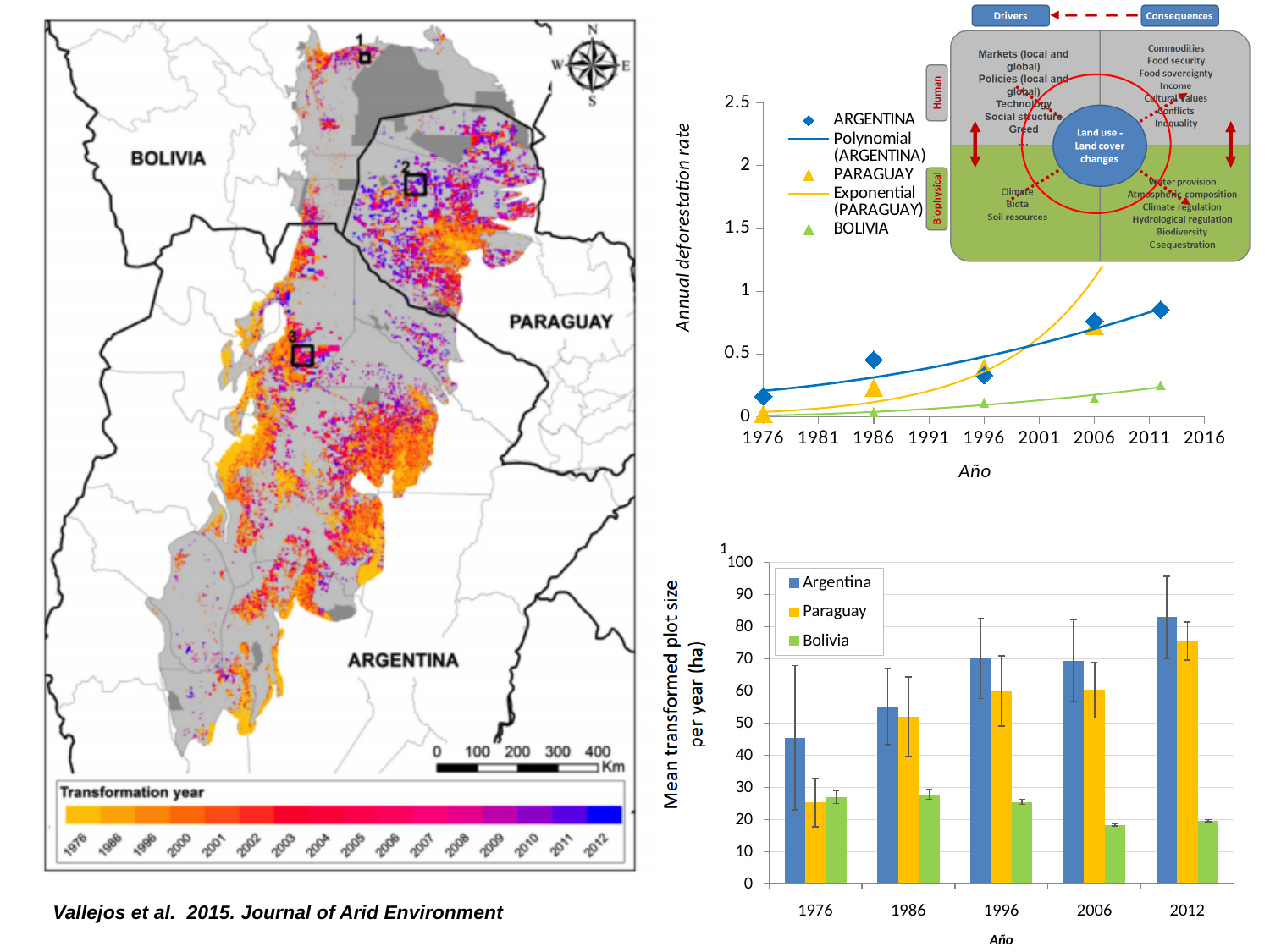
In the top-right 'Annual deforestation rate' chart, is the ARGENTINA value for 2012 greater or less than 0.5? greater In the bottom-right bar chart, is the Bolivia value for 2006 greater or less than 20? less In the top-right 'Annual deforestation rate' chart, do the BOLIVIA values rise or fall from 1976 to 2012? rise How many series does the legend of the bottom-right bar chart list? 3 In the bottom-right bar chart, is the Argentina value for 1976 greater or less than 50? less What kind of chart is the bottom-right chart titled 'Mean transformed plot size per year (ha)'? bar chart How many year categories are shown on the x axis of the bottom-right bar chart? 5 In the bottom-right bar chart, which country has the tallest bar overall? Argentina How many entries does the legend of the top-right 'Annual deforestation rate' chart list? 5 In the bottom-right bar chart, which is larger in 1996: Argentina or Bolivia? Argentina